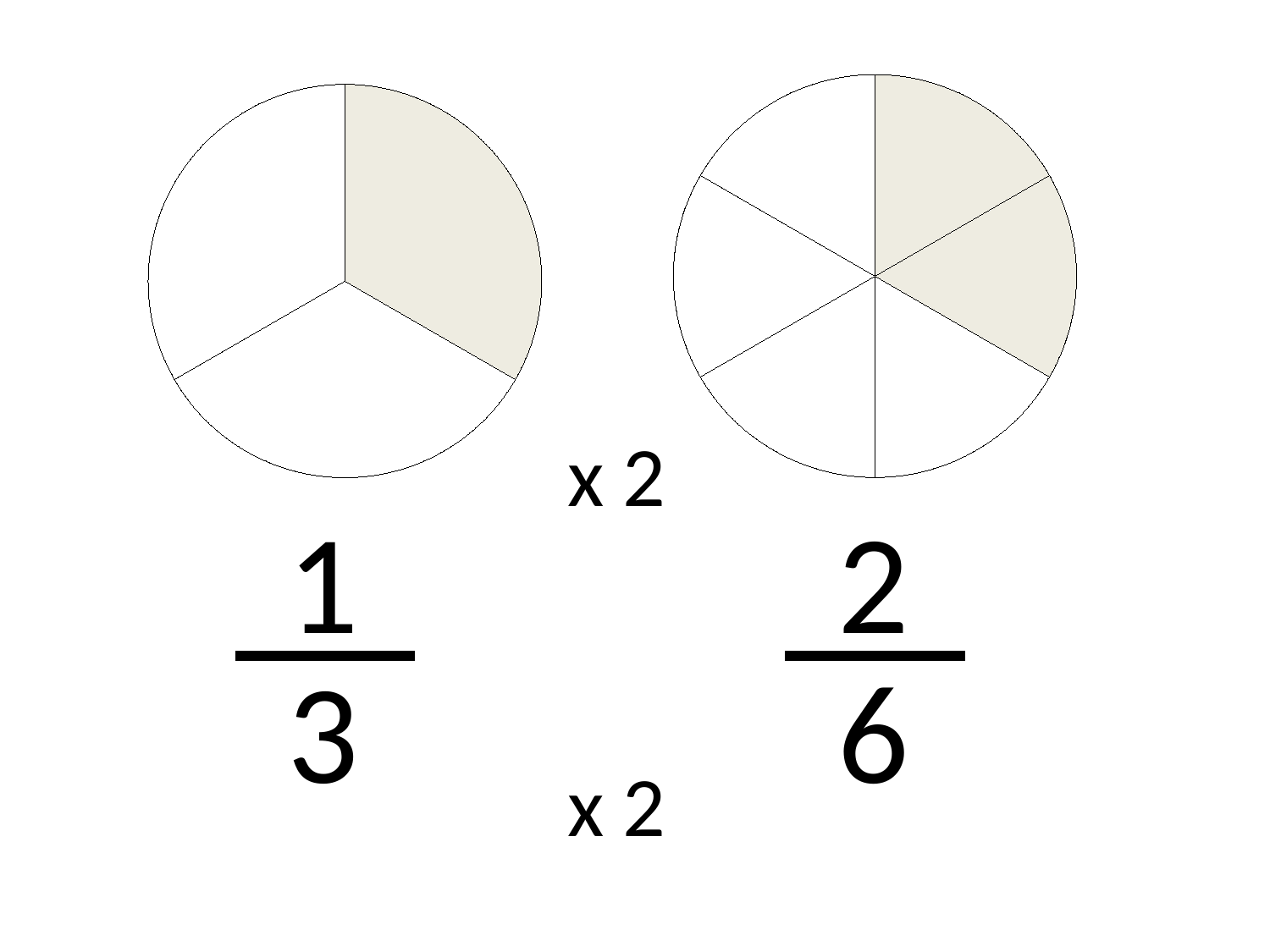
What kind of chart are the two diagrams on the slide? pie chart What fraction is written below the right circle? 2/6 What multiplier is written between the two fractions on the slide? x 2 On the right circle, how many equal sections is the circle divided into? 6 Which circle is divided into more sections, the left or the right? right On the left circle, how many sections are shaded? 1 On the right circle, what fraction of the circle is shaded? 2/6 On the left circle, what fraction of the circle is shaded? 1/3 On the right circle, how many sections are shaded? 2 What fraction is written below the left circle? 1/3